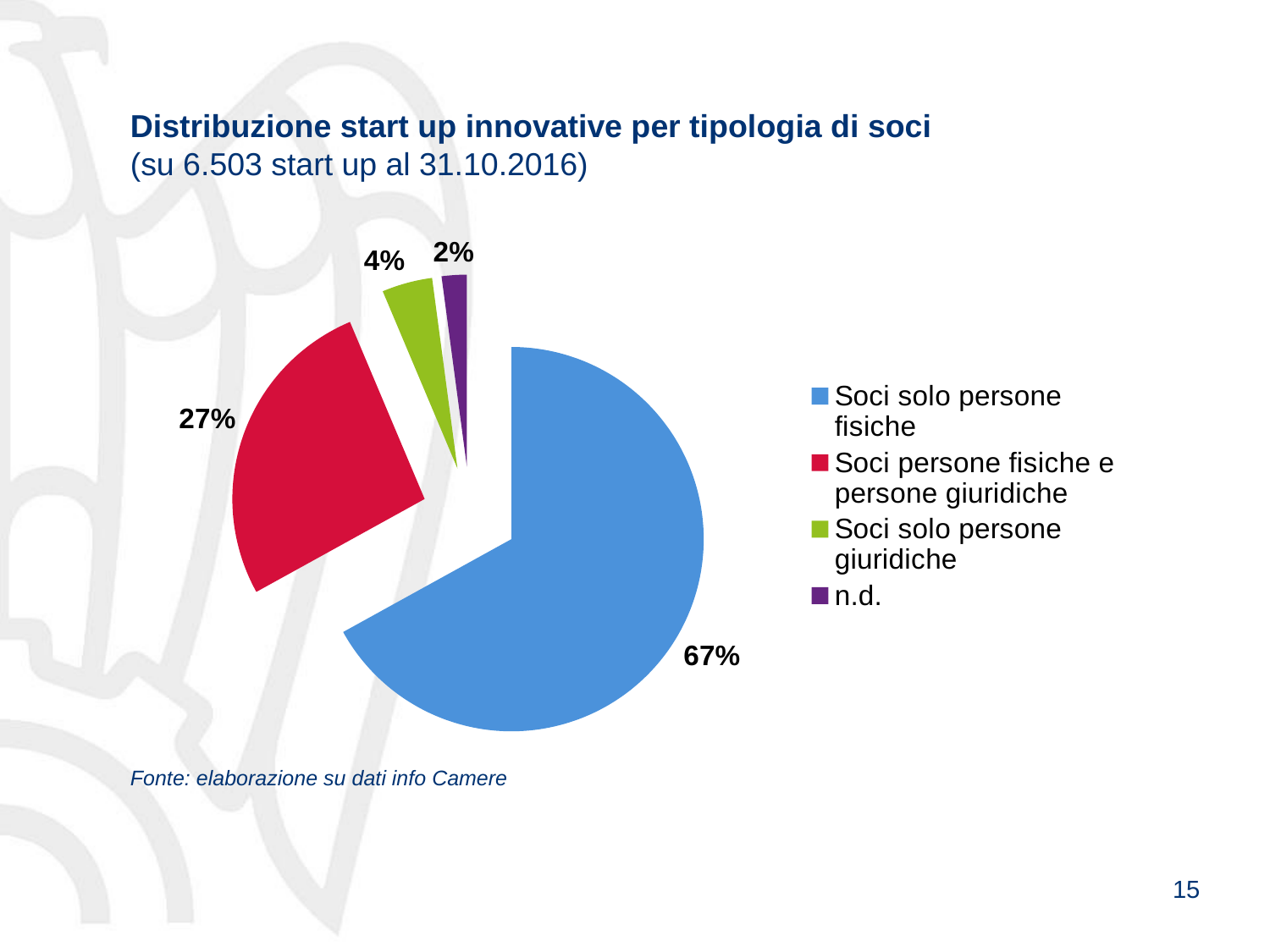
What is the difference in percentage points between 'Soci solo persone fisiche' and 'Soci persone fisiche e persone giuridiche'? 40 percentage points What is the title of the chart? Distribuzione start up innovative per tipologia di soci What share of the pie is 'Soci persone fisiche e persone giuridiche'? 27% Which category has the largest share of the pie? Soci solo persone fisiche Which category has the smallest share of the pie? n.d. What share of the pie is 'n.d.'? 2% What share of the pie is 'Soci solo persone fisiche'? 67% Which is larger: the share for 'Soci solo persone giuridiche' or the share for 'n.d.'? Soci solo persone giuridiche How many categories does the legend list? 4 What kind of chart is shown on the slide? Pie chart What colour is the slice for 'Soci persone fisiche e persone giuridiche'? Red What share of the pie is 'Soci solo persone giuridiche'? 4%